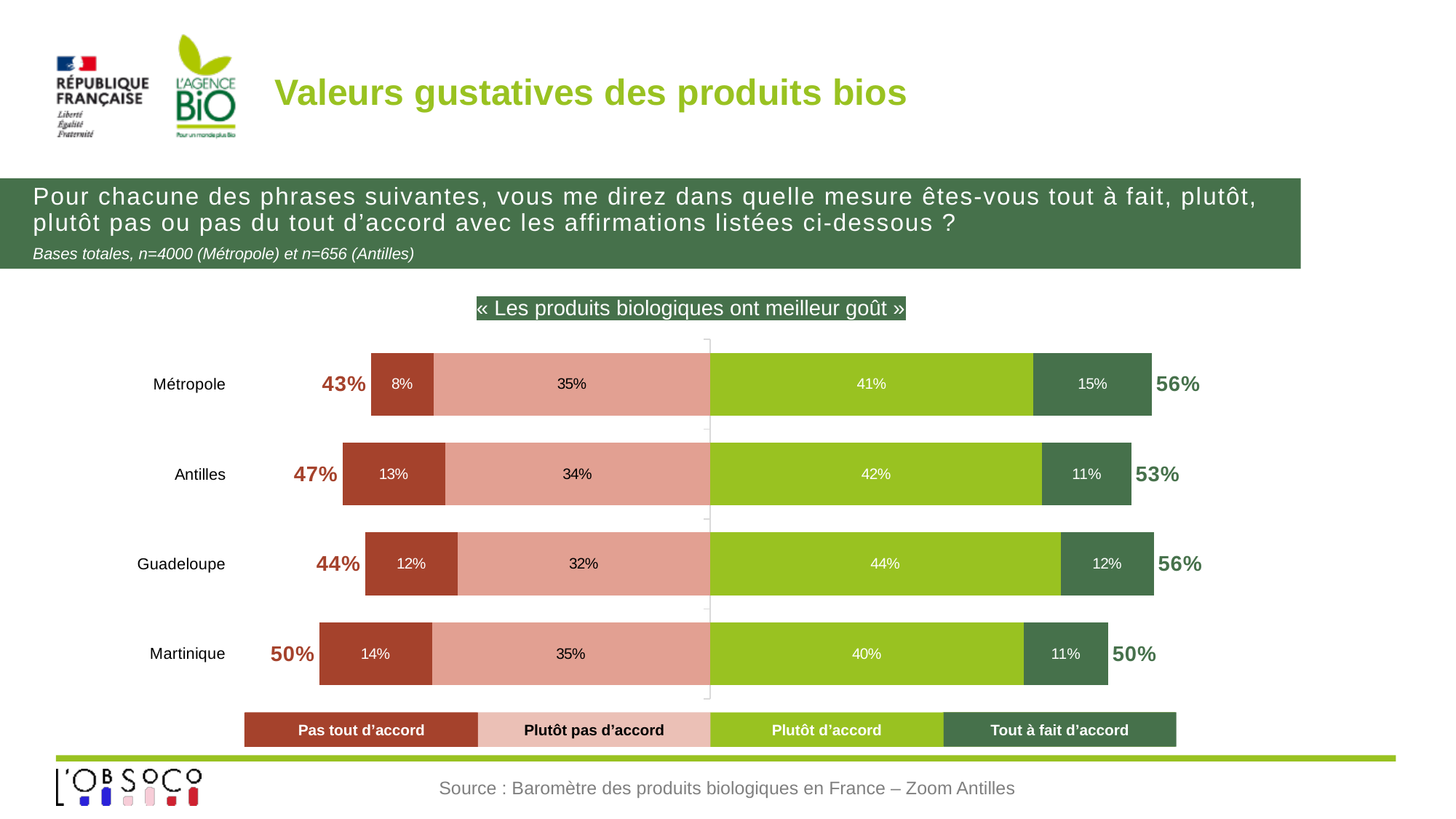
Which region has the lowest "Pas tout d'accord" share? Métropole What is the total agreement share (Plutôt d'accord plus Tout à fait d'accord) shown for Martinique? 50% What is the "Pas tout d'accord" value for Martinique? 14% What is the difference between the "Plutôt pas d'accord" values for Métropole and Guadeloupe? 3 percentage points How many regions are shown in the chart? 4 Which region has the highest "Plutôt d'accord" share? Guadeloupe Which statement is the chart about? « Les produits biologiques ont meilleur goût » What is the "Tout à fait d'accord" value for Métropole? 15% What kind of chart is shown on the slide? Stacked bar chart Which is larger: the "Tout à fait d'accord" value for Métropole or for Guadeloupe? Métropole How many series does the legend list? 4 What percentage of respondents in Antilles answered "Plutôt d'accord" to "Les produits biologiques ont meilleur goût"? 42%